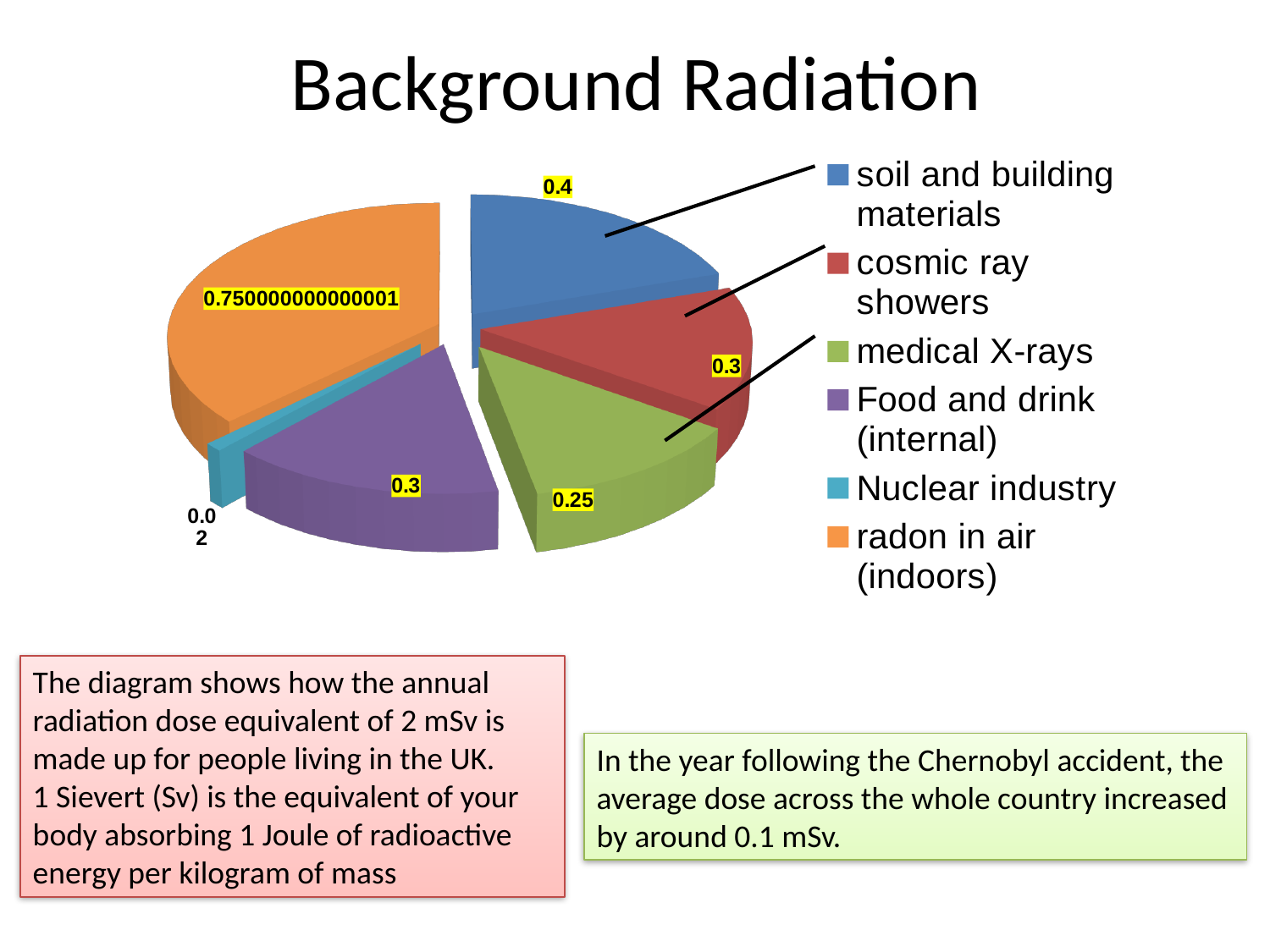
What is the value labelled on the radon in air (indoors) slice? 0.7500000000000001 Which category has the smallest slice of the pie? Nuclear industry What kind of chart is shown on the slide? pie chart Which category has the largest slice of the pie? radon in air (indoors) How many categories does the pie chart have? 6 Which is larger, the value for soil and building materials or the value for medical X-rays? soil and building materials What is the value for medical X-rays? 0.25 What is the value for soil and building materials? 0.4 What is the value for cosmic ray showers? 0.3 What is the difference between the values for soil and building materials and cosmic ray showers? 0.1 What is the value for Nuclear industry? 0.02 What is the title of the slide containing the chart? Background Radiation